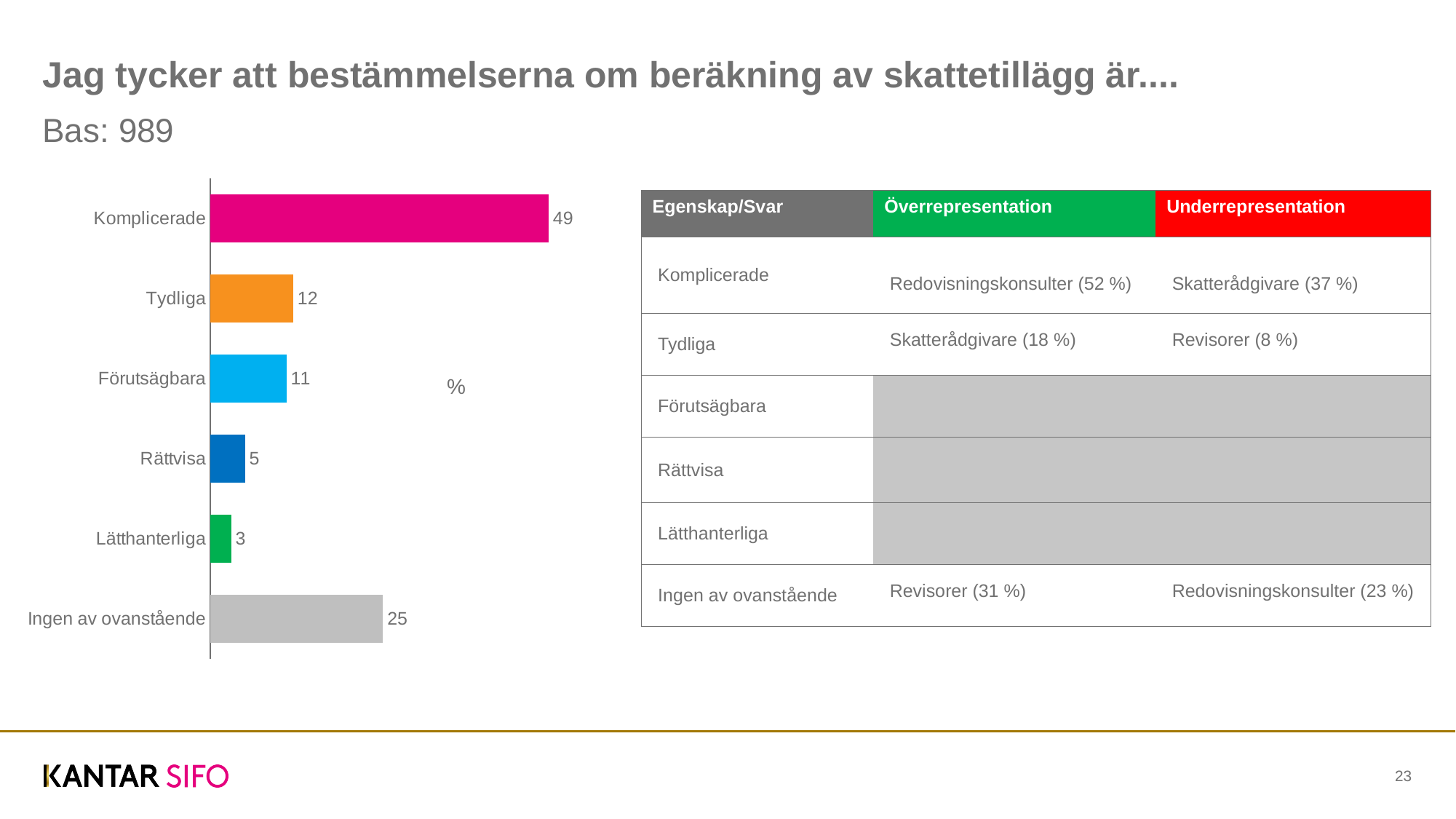
What is the value for Komplicerade? 49 What is the value for Ingen av ovanstående? 25 What is the difference between the values for Tydliga and Rättvisa? 7 Which is larger, the value for Förutsägbara or the value for Rättvisa? Förutsägbara What kind of chart is shown on the slide? Bar chart What colour is the bar for Komplicerade? Pink Which category has the highest value? Komplicerade What is the difference between the values for Komplicerade and Ingen av ovanstående? 24 How many categories are shown in the bar chart? 6 What is the value for Tydliga? 12 Which category has the lowest value? Lätthanterliga What is the value for Lätthanterliga? 3